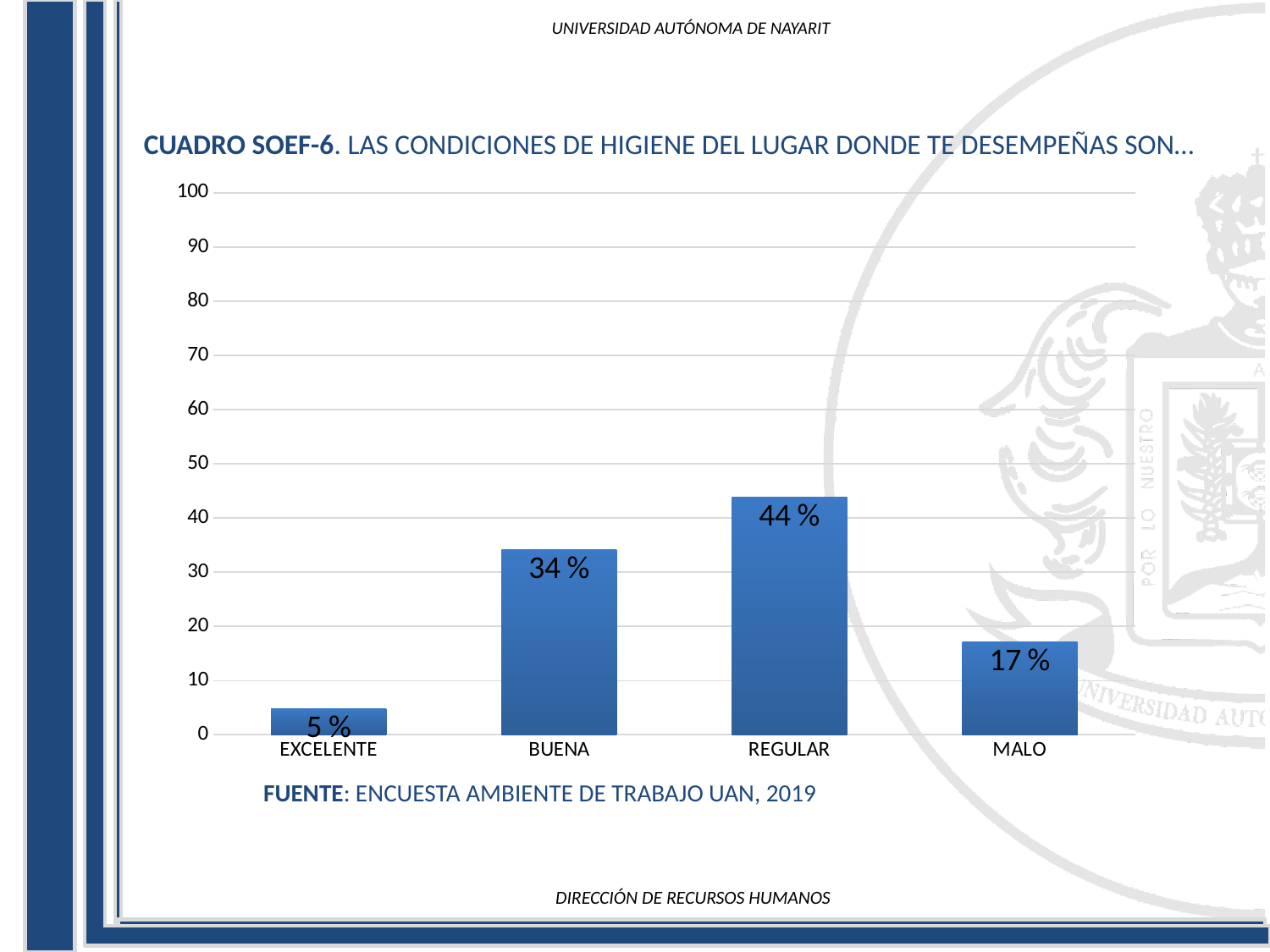
How many categories are shown on the x axis? 4 Which category has the highest value? REGULAR Which is larger, the value for BUENA or the value for MALO? BUENA What kind of chart is shown on the slide? bar chart What source is cited below the chart? ENCUESTA AMBIENTE DE TRABAJO UAN, 2019 What is the value for EXCELENTE? 5 % What is the difference between the values for MALO and EXCELENTE? 12 % What is the value for MALO? 17 % What is the value for REGULAR? 44 % Is the value for BUENA greater or less than 30? greater Which category has the lowest value? EXCELENTE What is the difference between the values for REGULAR and BUENA? 10 %